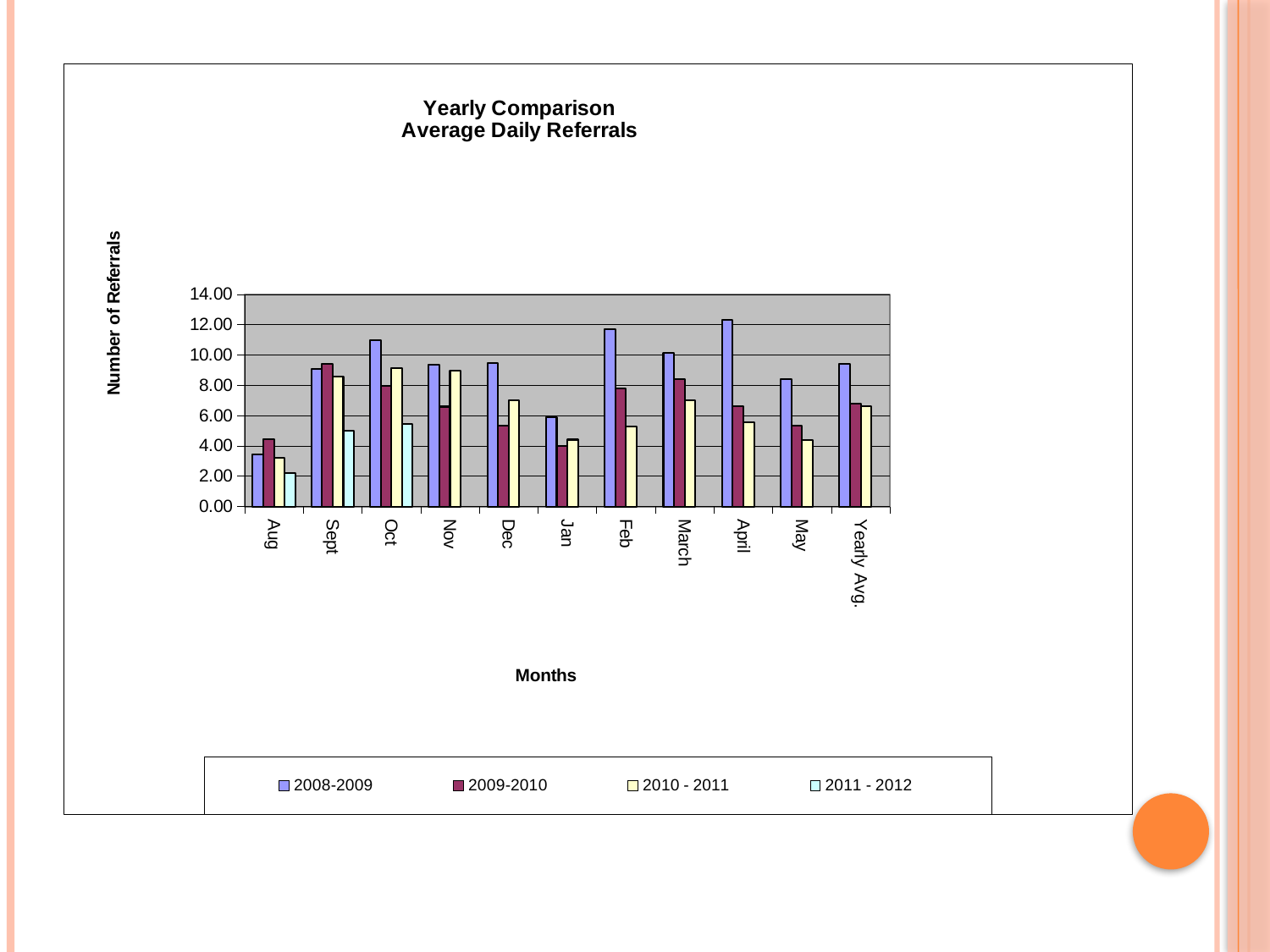
Which month has the highest value for the 2009-2010 series? Sept Which month has the lowest value for the 2010 - 2011 series? Aug Is the value for Aug in the 2011 - 2012 series greater or less than 4.00? less Do the values for the 2011 - 2012 series rise or fall from Aug to Oct? rise Which month has the lowest value for the 2008-2009 series? Aug Is the value for Feb in the 2008-2009 series greater or less than 10.00? greater What is the label of the y axis? Number of Referrals For Oct, which series has the larger value, 2008-2009 or 2009-2010? 2008-2009 What is the title of the chart? Yearly Comparison Average Daily Referrals How many categories are shown on the x axis? 11 How many series does the legend list? 4 What kind of chart is shown on the slide? bar chart